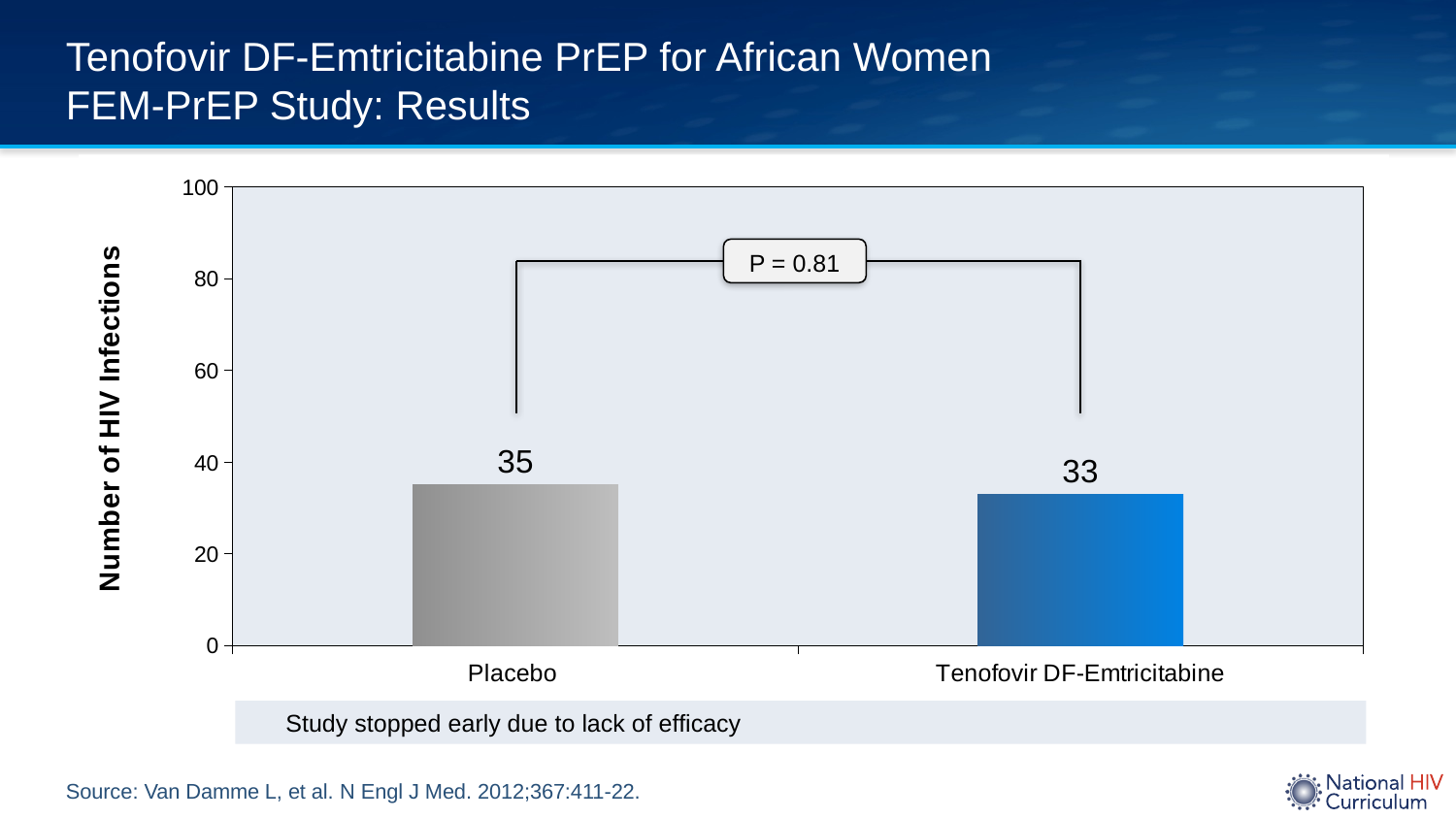
What kind of chart is shown on the slide? Bar chart Is the number of HIV infections in the Tenofovir DF-Emtricitabine group greater or less than 20? greater What is the label of the y axis of the chart? Number of HIV Infections How many HIV infections occurred in the Tenofovir DF-Emtricitabine group? 33 How many groups are shown on the x axis of the chart? 2 Which group had the higher number of HIV infections? Placebo What is the maximum value shown on the y axis of the chart? 100 Is the number of HIV infections in the Placebo group greater or less than 40? less What is the P value shown on the chart comparing the two groups? P = 0.81 Which group had the lower number of HIV infections? Tenofovir DF-Emtricitabine How many HIV infections occurred in the Placebo group? 35 What is the difference in the number of HIV infections between the Placebo and Tenofovir DF-Emtricitabine groups? 2